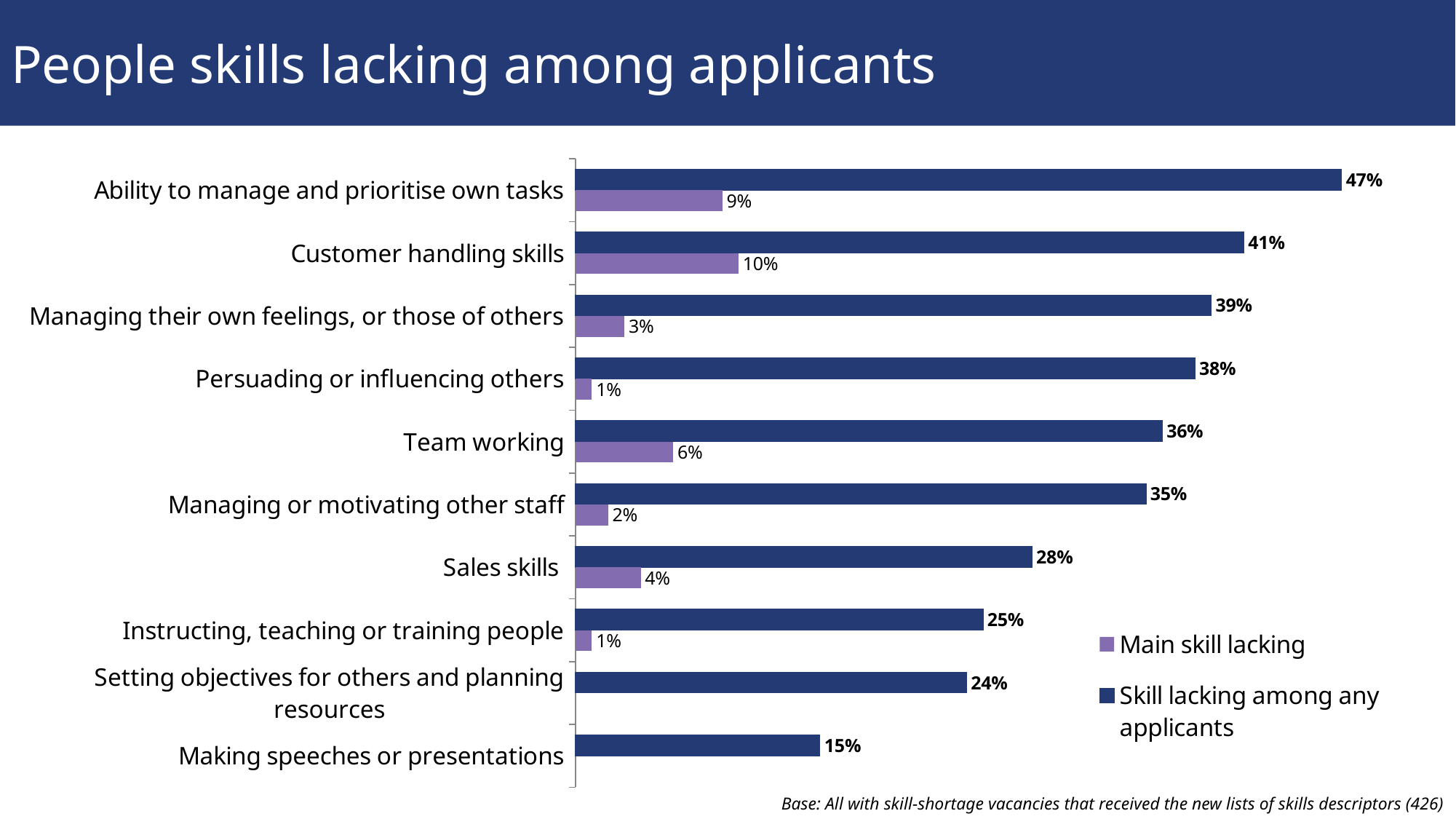
Which category has the lowest value for 'Skill lacking among any applicants'? Making speeches or presentations How many series does the legend list? 2 Which category has the highest value for 'Main skill lacking'? Customer handling skills What kind of chart is shown on the slide? Bar chart What is the value for 'Main skill lacking' for Team working? 6% What is the title of the slide? People skills lacking among applicants Which is larger: the 'Skill lacking among any applicants' value for Team working or for Managing or motivating other staff? Team working What is the value for 'Skill lacking among any applicants' for Customer handling skills? 41% What is the difference between the 'Skill lacking among any applicants' value and the 'Main skill lacking' value for Sales skills? 24% Which category has the highest value for 'Skill lacking among any applicants'? Ability to manage and prioritise own tasks What is the 'Main skill lacking' value for Persuading or influencing others? 1% How many categories are shown on the chart? 10